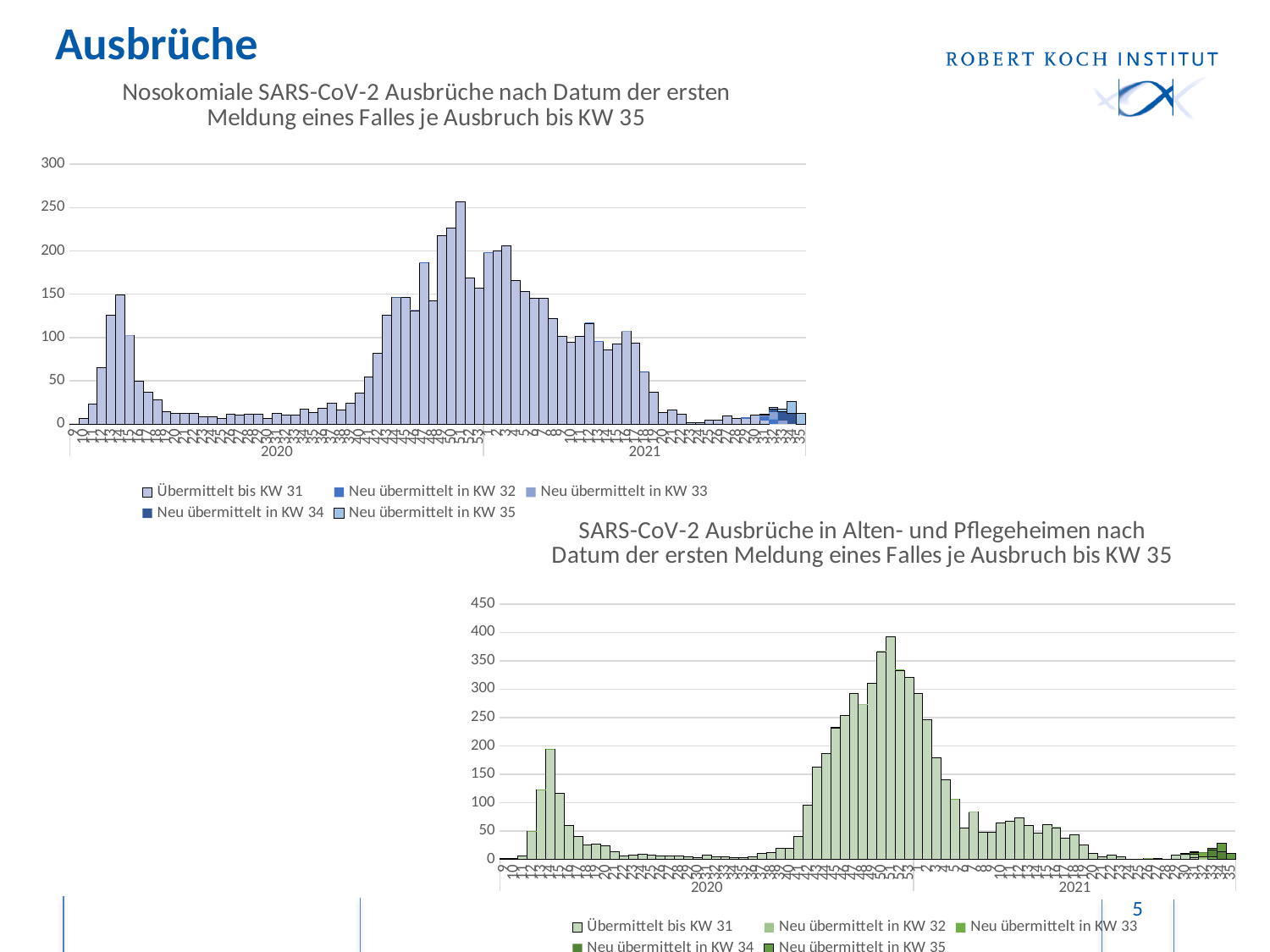
What is the highest value shown on the y axis of the bottom chart (Alten- und Pflegeheime)? 450 What is the highest value shown on the y axis of the top chart (Nosokomiale SARS-CoV-2 Ausbrüche)? 300 How many series does the legend of the bottom chart (Alten- und Pflegeheime) list? 5 In the bottom chart (Alten- und Pflegeheime), do the values rise or fall from the start of 2021 to KW 35 of 2021? fall In the top chart (Nosokomiale SARS-CoV-2 Ausbrüche), is the highest bar greater or less than 200? greater What kind of chart is the top chart titled 'Nosokomiale SARS-CoV-2 Ausbrüche nach Datum der ersten Meldung eines Falles je Ausbruch bis KW 35'? bar chart Which two years are labelled on the x axis of the top chart (Nosokomiale SARS-CoV-2 Ausbrüche)? 2020 and 2021 How many series does the legend of the top chart (Nosokomiale SARS-CoV-2 Ausbrüche) list? 5 What kind of chart is the bottom chart titled 'SARS-CoV-2 Ausbrüche in Alten- und Pflegeheimen nach Datum der ersten Meldung eines Falles je Ausbruch bis KW 35'? bar chart In the bottom chart (Alten- und Pflegeheime), is the highest bar greater or less than 350? greater Which chart reaches a higher peak value, the top chart (Nosokomiale Ausbrüche) or the bottom chart (Alten- und Pflegeheime)? the bottom chart (Alten- und Pflegeheime)